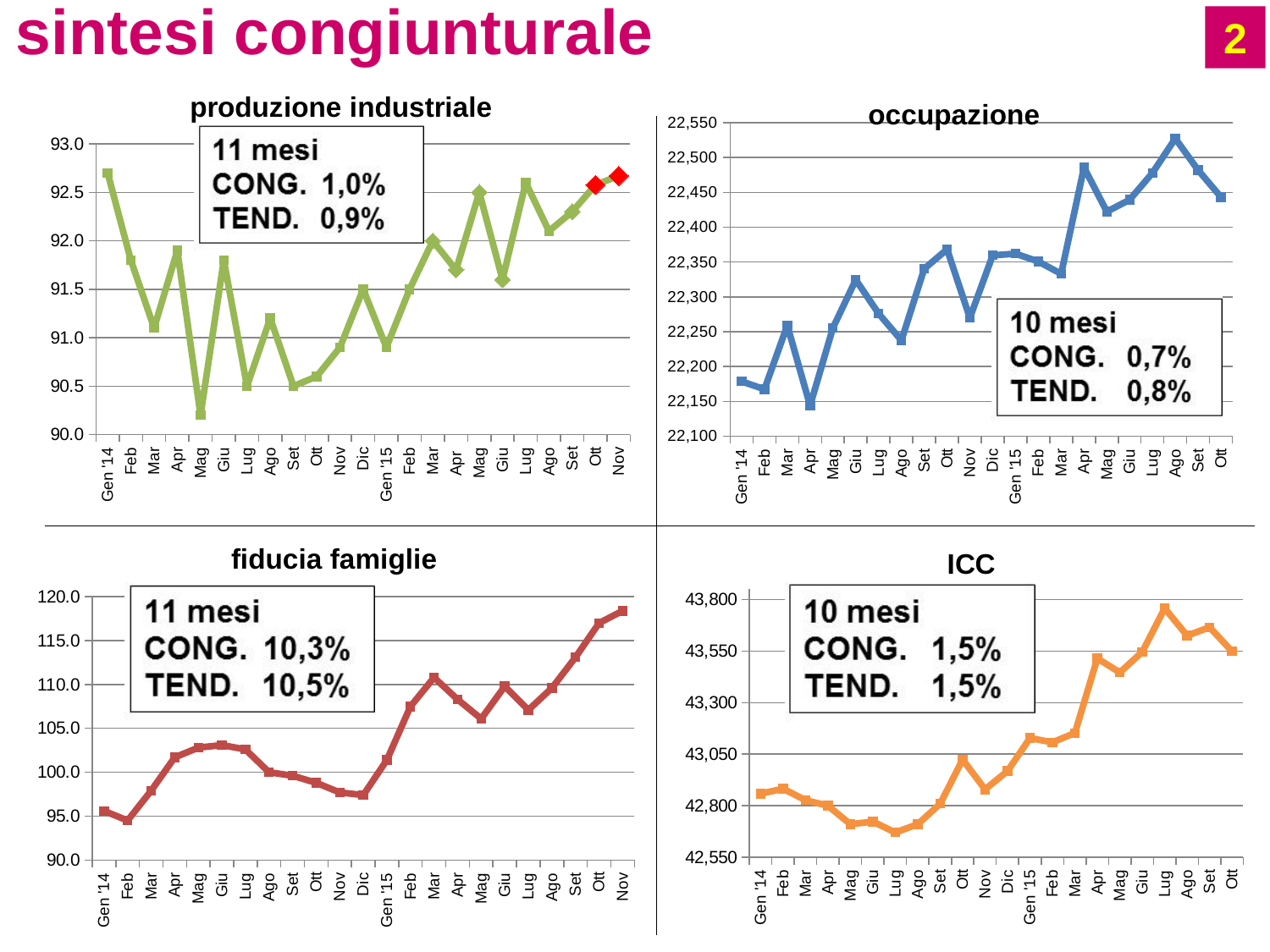
In the 'ICC' chart, which month has the highest value? Lug '15 In the 'fiducia famiglie' chart, which month has the lowest value? Feb '14 In the 'fiducia famiglie' chart, is the value for Nov '15 greater or less than 115.0? greater In the 'occupazione' chart, which month has the highest value? Ago '15 How many data points are plotted in the 'produzione industriale' chart? 23 In the 'produzione industriale' chart, is the value for Mag '14 greater or less than 90.5? less In the 'ICC' chart, is the value for Lug '14 greater or less than 42,800? less In the 'produzione industriale' chart, which month has the lowest value? Mag '14 In the 'occupazione' chart, which is larger, the value for Apr '15 or Mag '15? Apr '15 What CONG. value is shown in the text box on the 'produzione industriale' chart? 1,0% What kind of chart is the 'produzione industriale' chart? line chart